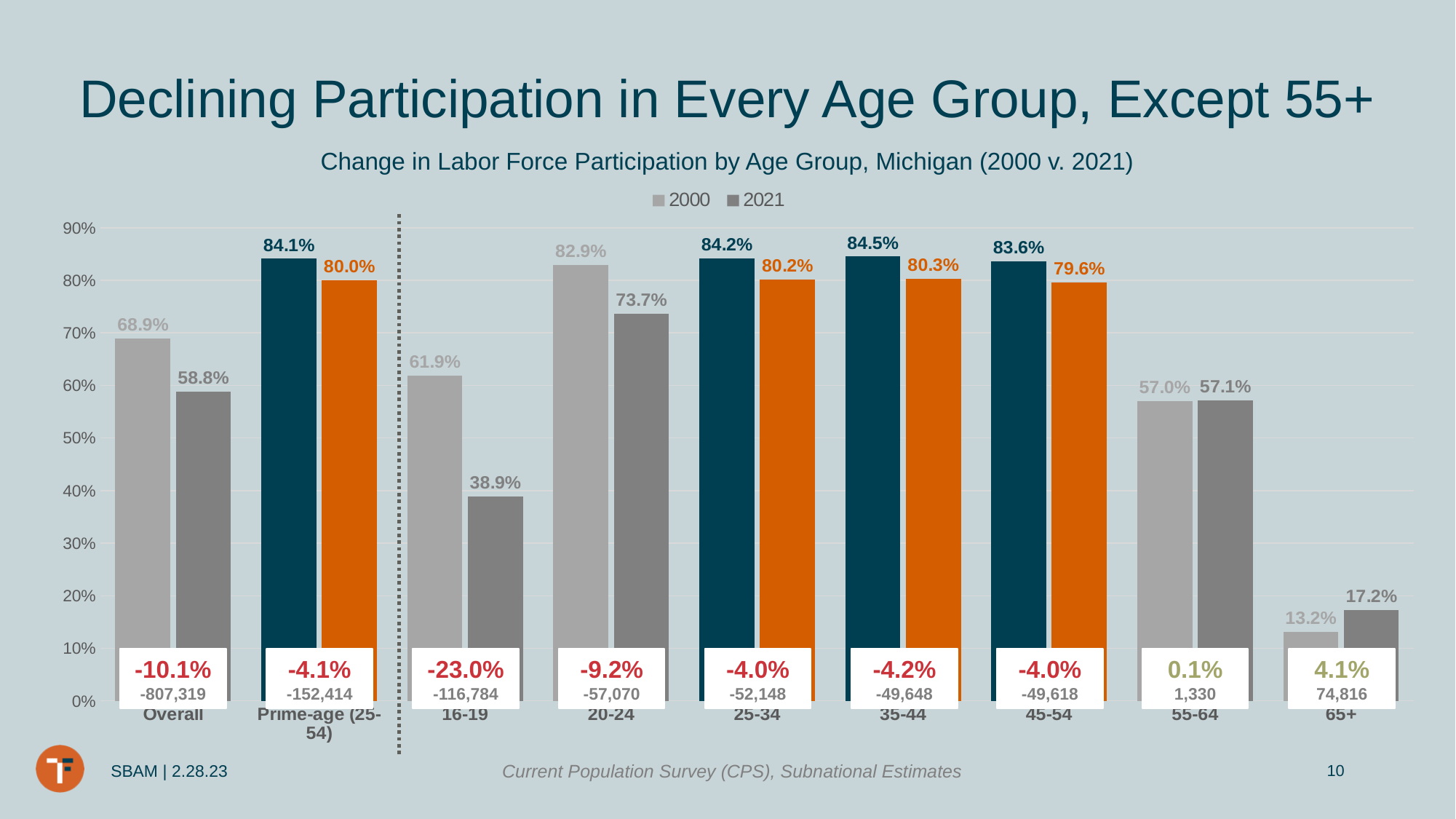
Which category has the lowest 2021 participation rate? 65+ What is the difference between the 2000 and 2021 participation rates for the 20-24 age group? 9.2 percentage points What was the Overall labor force participation rate in 2000? 68.9% What was the labor force participation rate for the 16-19 age group in 2021? 38.9% What was the labor force participation rate for the 65+ age group in 2021? 17.2% What is the chart's title? Change in Labor Force Participation by Age Group, Michigan (2000 v. 2021) How many categories are shown on the x axis? 9 What kind of chart is shown on the slide? Bar chart Which age group category has the highest 2000 participation rate? 35-44 Which is larger: the 2021 participation rate for 25-34 or for 45-54? 25-34 What is the percentage change label shown for the 55-64 age group? 0.1% How many series does the legend list? 2